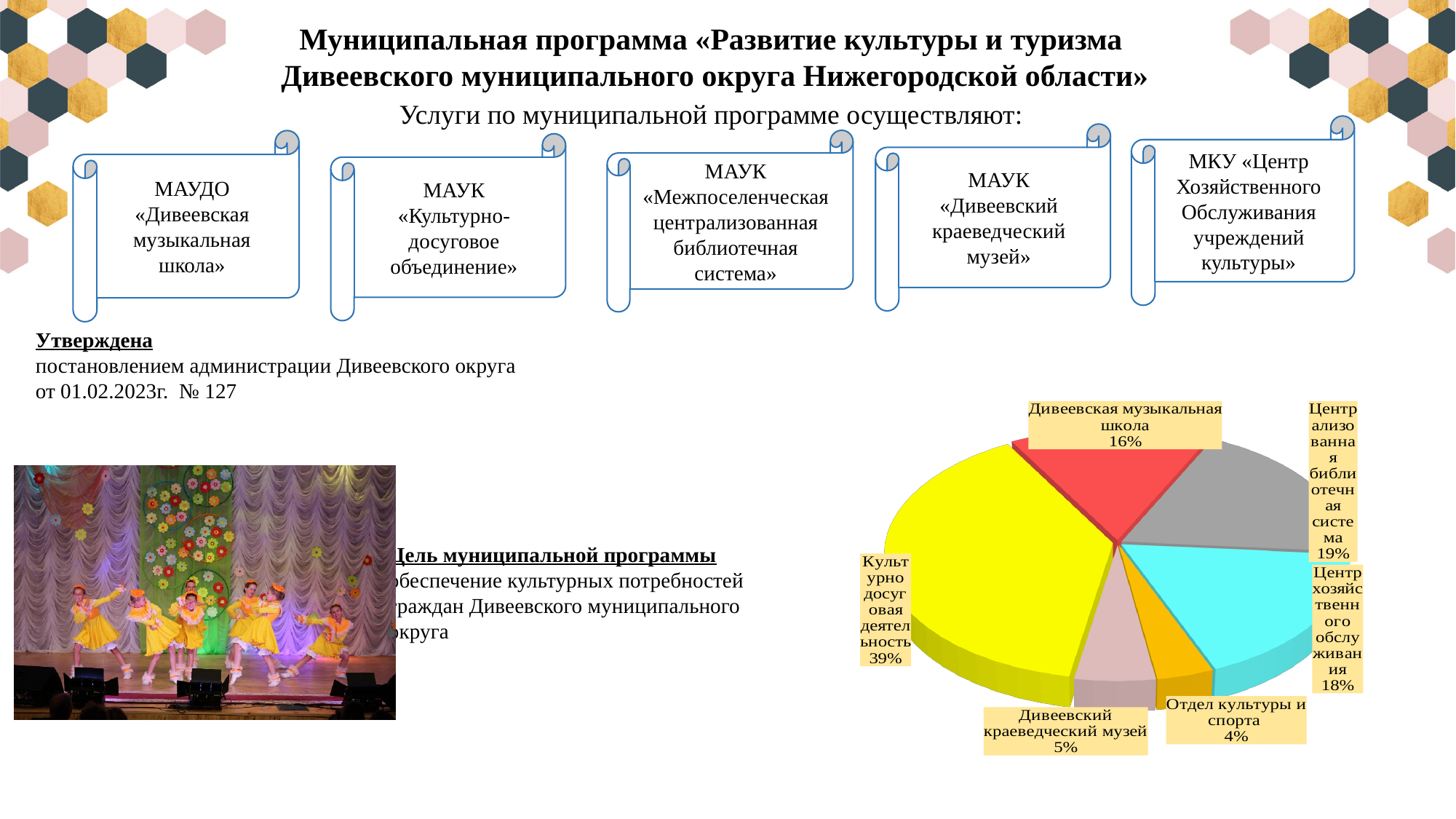
What kind of chart is shown on the slide? pie chart What share of the pie does «Центр хозяйственного обслуживания» have? 18% What is the difference in percentage points between «Культурно-досуговая деятельность» and «Дивеевская музыкальная школа»? 23 What share of the pie does «Отдел культуры и спорта» have? 4% What share of the pie does «Дивеевская музыкальная школа» have? 16% How many slices does the pie chart have? 6 Which is larger: the share of «Централизованная библиотечная система» or the share of «Дивеевский краеведческий музей»? Централизованная библиотечная система What share of the pie does «Дивеевский краеведческий музей» have? 5% What share of the pie does «Культурно-досуговая деятельность» have? 39% Which slice of the pie chart is the smallest? Отдел культуры и спорта Which slice of the pie chart is the largest? Культурно-досуговая деятельность What share of the pie does «Централизованная библиотечная система» have? 19%